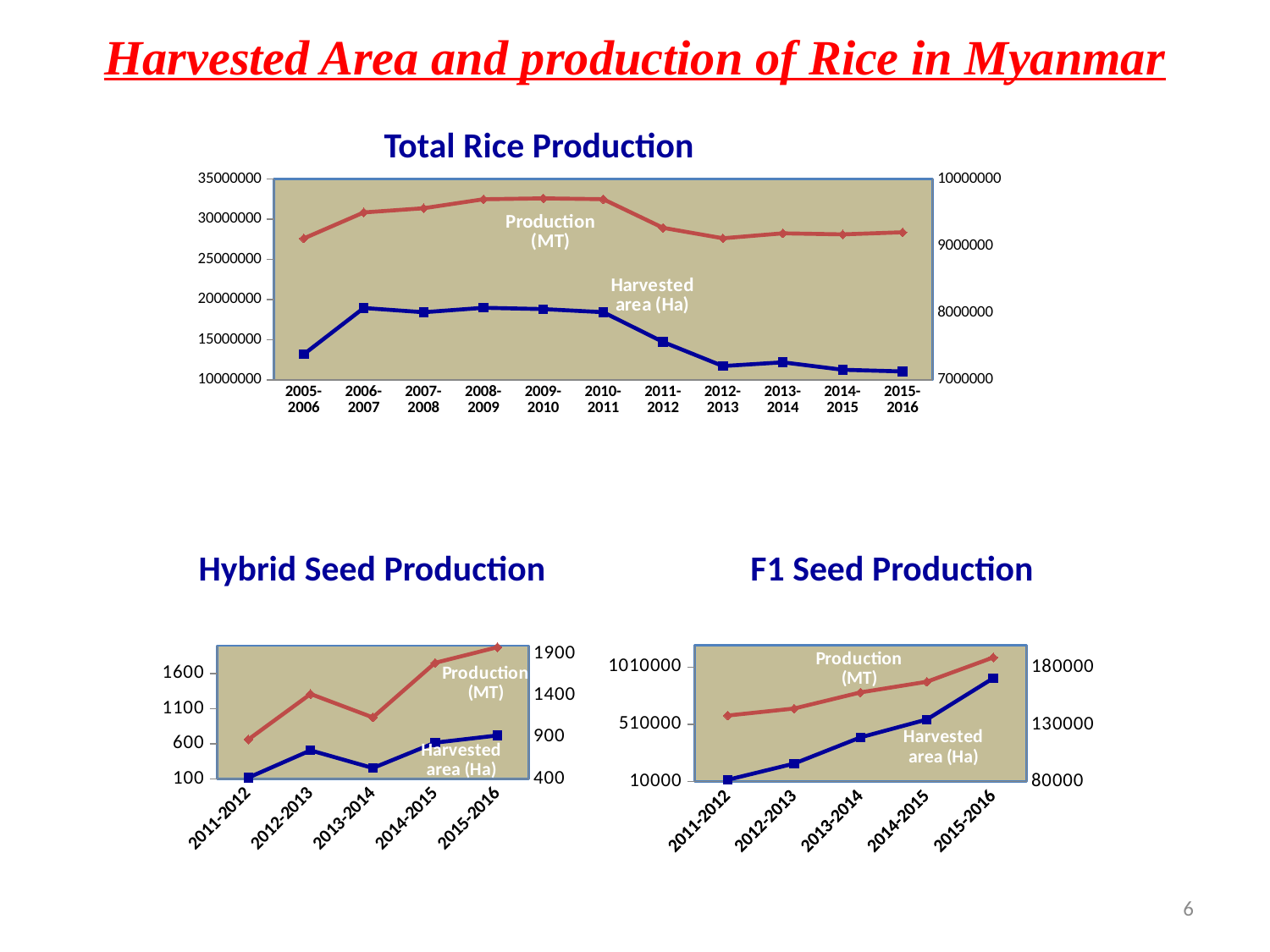
What colour is the Harvested area (Ha) line in the F1 Seed Production chart? blue In the Hybrid Seed Production chart, is Production (MT) higher in 2012-2013 or in 2013-2014? 2012-2013 How many year periods are shown on the x axis of the Hybrid Seed Production chart? 5 How many year periods are shown on the x axis of the Total Rice Production chart? 11 How many series are plotted in the Total Rice Production chart? 2 In the Total Rice Production chart, is Harvested area (Ha) higher in 2006-2007 or in 2012-2013? 2006-2007 What kind of chart is the Total Rice Production chart? line chart In the F1 Seed Production chart, does Harvested area (Ha) rise or fall from 2011-2012 to 2015-2016? rise In the Hybrid Seed Production chart, which year period has the highest Production (MT)? 2015-2016 In the Total Rice Production chart, is Production (MT) higher in 2010-2011 or in 2012-2013? 2010-2011 In the F1 Seed Production chart, which year period has the lowest Production (MT)? 2011-2012